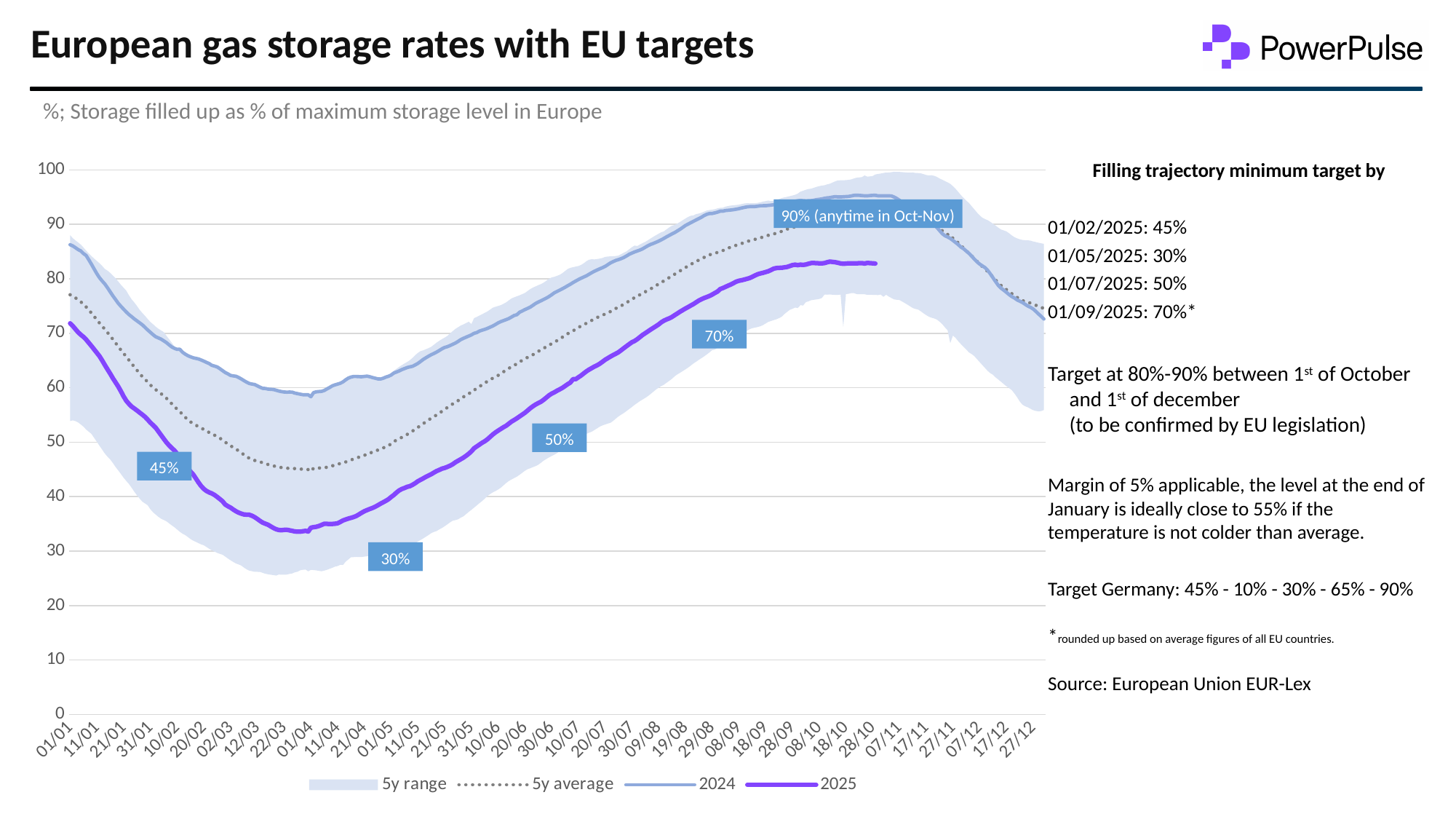
At 28/10, which line is higher: 2024 or 2025? 2024 How many series does the chart legend list? 4 At 01/01, which line is higher: 2024 or 2025? 2024 Is the value of the 2024 line at 01/01 greater or less than 80? greater What kind of chart is shown on the slide? line chart Does the 2025 line rise or fall between 01/04 and 28/10? rise Does the 2024 line rise or fall between 01/01 and 22/03? fall Is the lowest point of the 2025 line (around 22/03) greater or less than 40? less Is the value of the 2025 line at 01/01 greater or less than 60? greater Which series in the legend is drawn as a dotted line? 5y average